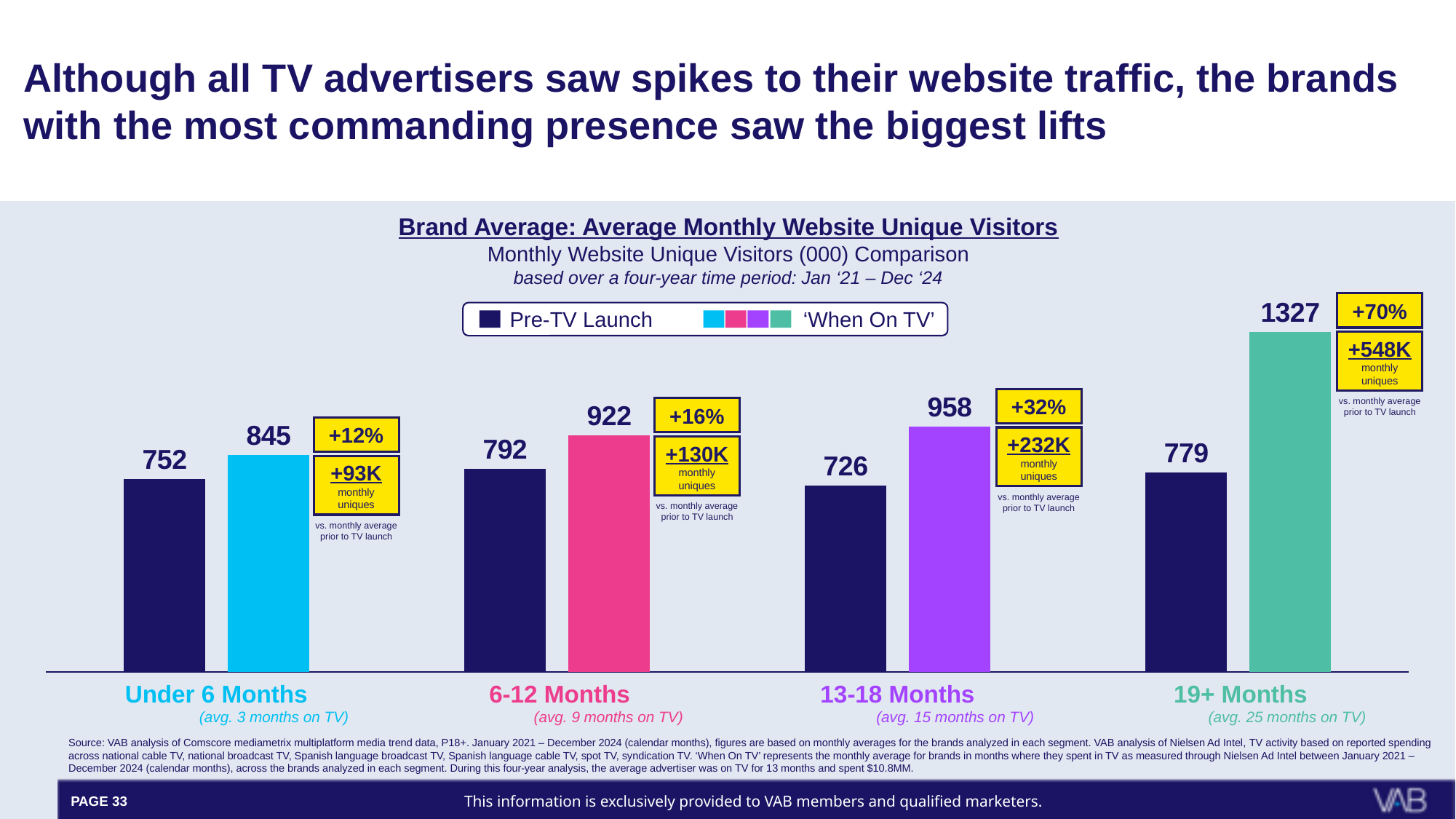
Which is larger: the Pre-TV Launch value for 19+ Months or the Pre-TV Launch value for Under 6 Months? 19+ Months How many categories are shown on the x axis? 4 What is the Pre-TV Launch value for the 6-12 Months category? 792 What kind of chart is shown on the slide? Bar chart What is the difference between the 'When On TV' and Pre-TV Launch values for the 6-12 Months category? 130 Which category has the lowest Pre-TV Launch value? 13-18 Months Which category has the highest 'When On TV' value? 19+ Months What is the 'When On TV' value for the 13-18 Months category? 958 What percentage lift is shown for the 13-18 Months category? +32% How many series does the legend list? 2 What is the 'When On TV' value for the 19+ Months category? 1327 What is the Pre-TV Launch value for the Under 6 Months category? 752